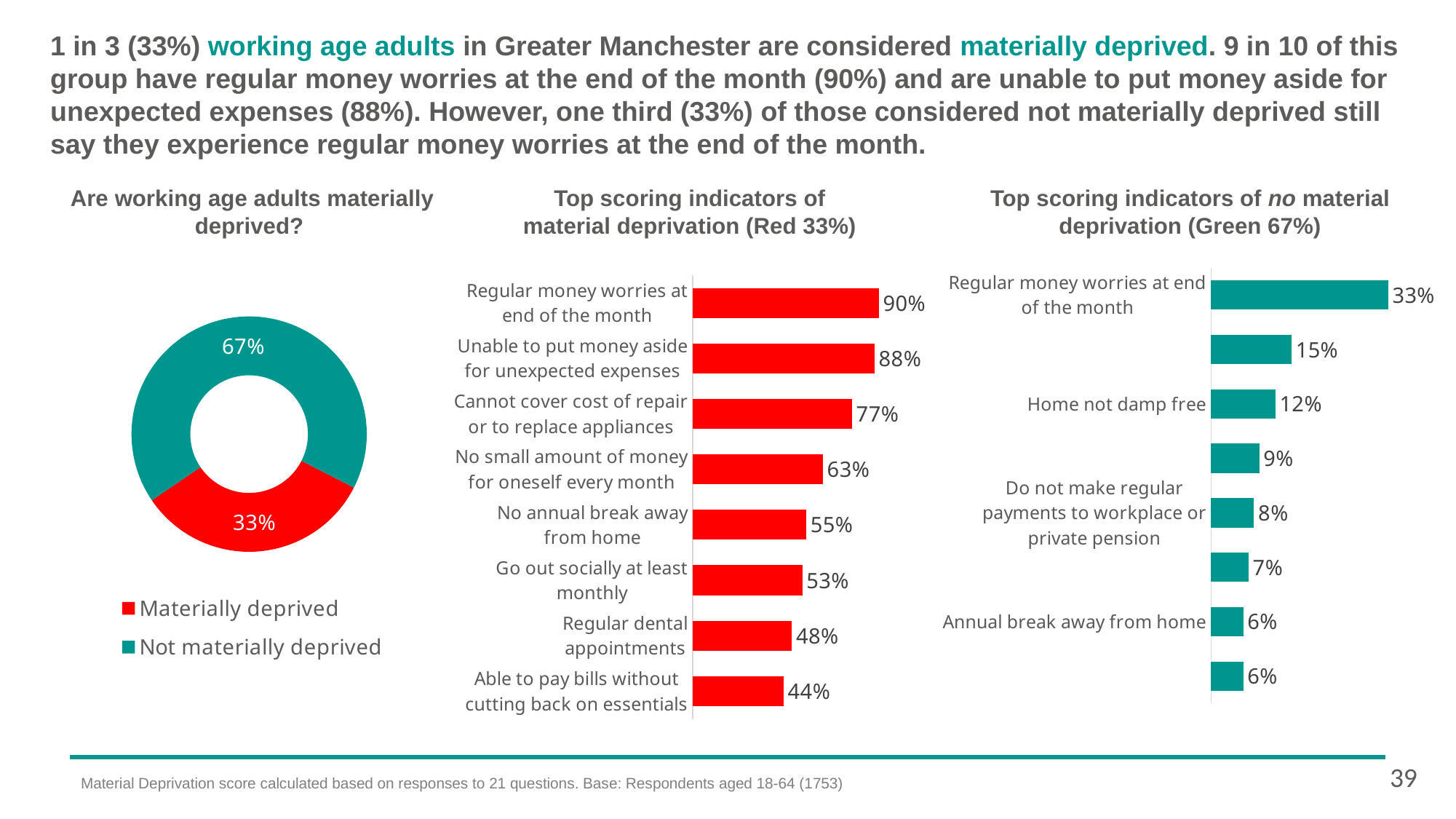
What kind of chart is the one titled 'Top scoring indicators of no material deprivation (Green 67%)'? Bar chart In the chart titled 'Top scoring indicators of no material deprivation (Green 67%)', what is the value for 'Home not damp free'? 12% In the chart titled 'Are working age adults materially deprived?', what share of working age adults are materially deprived? 33% In the chart titled 'Top scoring indicators of material deprivation (Red 33%)', which is larger: 'Regular dental appointments' or 'Go out socially at least monthly'? Go out socially at least monthly In the chart titled 'Top scoring indicators of no material deprivation (Green 67%)', which indicator has the highest value? Regular money worries at end of the month In the chart titled 'Are working age adults materially deprived?', how many entries does the legend list? 2 In the chart titled 'Top scoring indicators of material deprivation (Red 33%)', what is the value for 'Regular money worries at end of the month'? 90% In the chart titled 'Top scoring indicators of material deprivation (Red 33%)', which indicator has the lowest value? Able to pay bills without cutting back on essentials In the chart titled 'Top scoring indicators of material deprivation (Red 33%)', what is the difference between 'Cannot cover cost of repair or to replace appliances' and 'No annual break away from home'? 22% In the chart titled 'Top scoring indicators of material deprivation (Red 33%)', how many indicators are plotted? 8 In the chart titled 'Are working age adults materially deprived?', what share are not materially deprived? 67% What kind of chart is the one titled 'Are working age adults materially deprived?' Pie chart (donut)